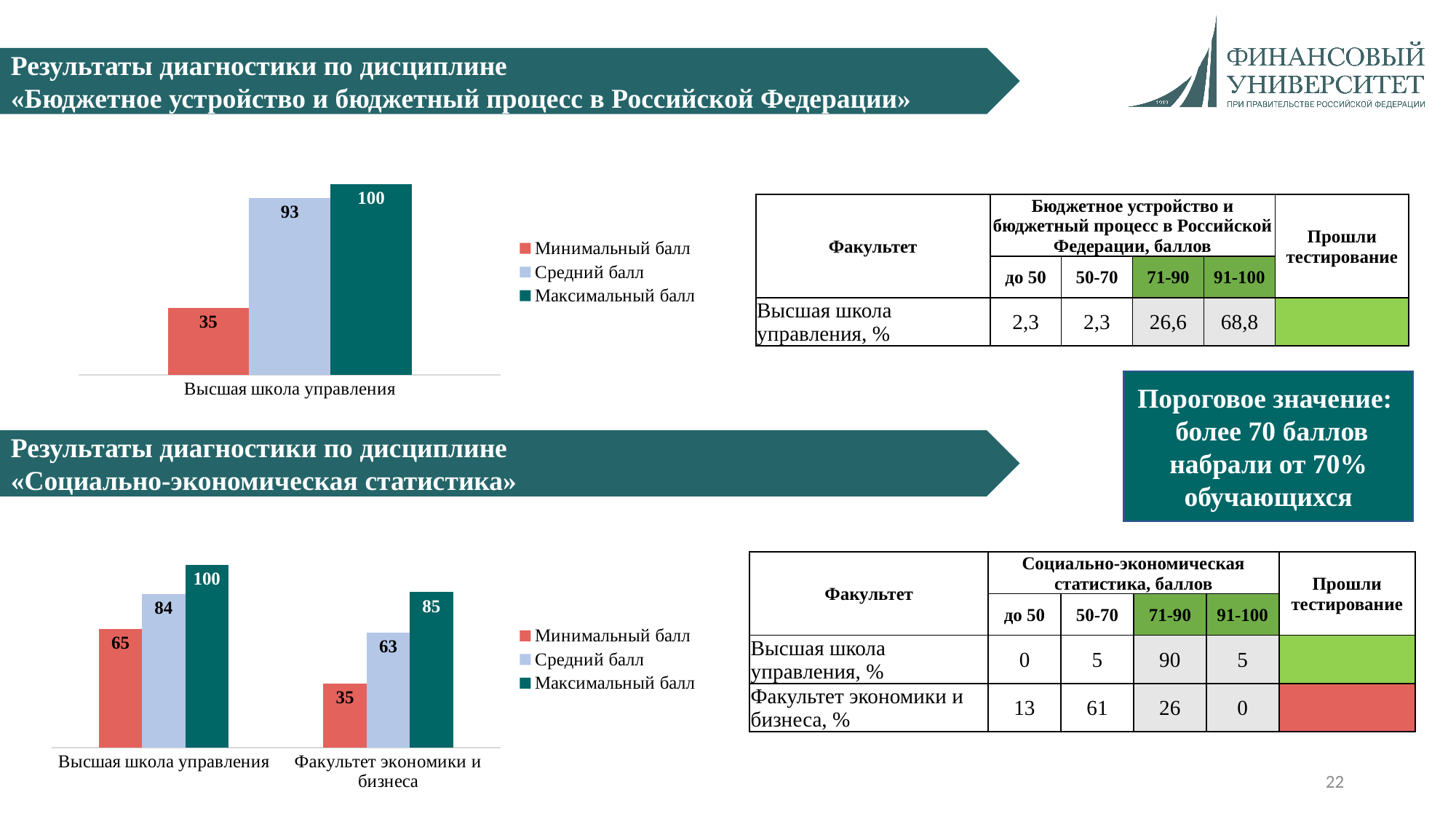
In the top chart, what is the difference between the Максимальный балл and the Минимальный балл for Высшая школа управления? 65 In the bottom chart, what is the Минимальный балл for Высшая школа управления? 65 In the bottom chart, which colour represents Максимальный балл in the legend? Dark teal How many series does the legend of the top chart list? 3 In the top chart (Бюджетное устройство и бюджетный процесс), what is the Минимальный балл for Высшая школа управления? 35 How many categories are shown on the x axis of the bottom chart? 2 What kind of chart is the top chart? Bar chart In the top chart, what is the Средний балл for Высшая школа управления? 93 In the bottom chart, what is the Максимальный балл for Факультет экономики и бизнеса? 85 In the bottom chart (Социально-экономическая статистика), what is the Средний балл for Факультет экономики и бизнеса? 63 In the bottom chart, what is the difference between the Средний балл of Высшая школа управления and Факультет экономики и бизнеса? 21 In the bottom chart, which category has the higher Средний балл? Высшая школа управления